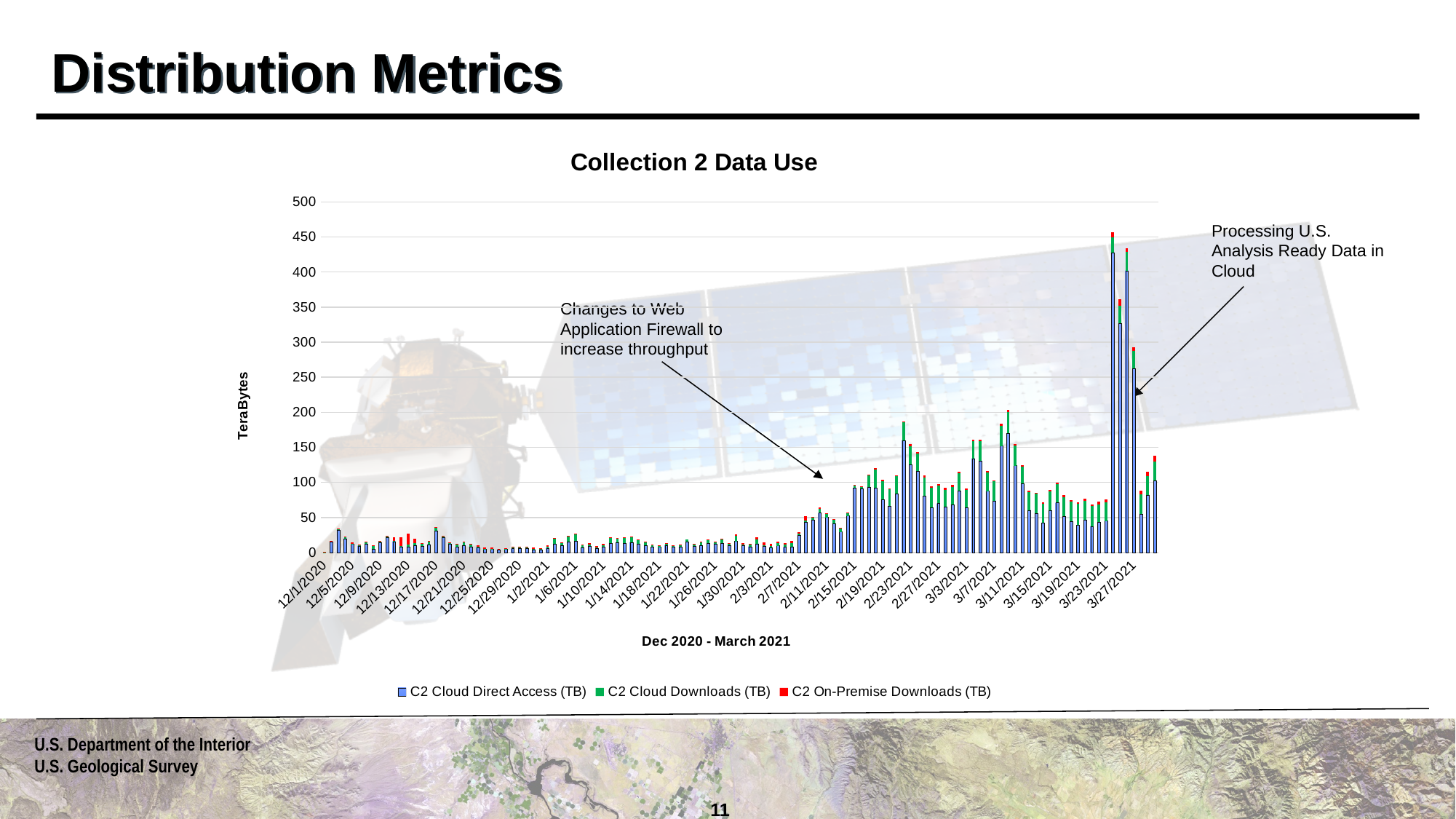
What kind of chart is shown on the slide? Bar chart Which has the larger value, 12/1/2020 or 3/27/2021? 3/27/2021 Overall, do the values rise or fall from December 2020 to March 2021? rise Is the value for 12/1/2020 greater or less than 50? less Is the value for 1/18/2021 greater or less than 50? less Is the tallest bar in the chart greater or less than 400? greater What is the title of the chart? Collection 2 Data Use How many series does the legend of the Collection 2 Data Use chart list? 3 In which month does the tallest bar of the chart occur? March 2021 Which has the larger value, 1/18/2021 or 3/3/2021? 3/3/2021 Which series is shown in green in the chart? C2 Cloud Downloads (TB)